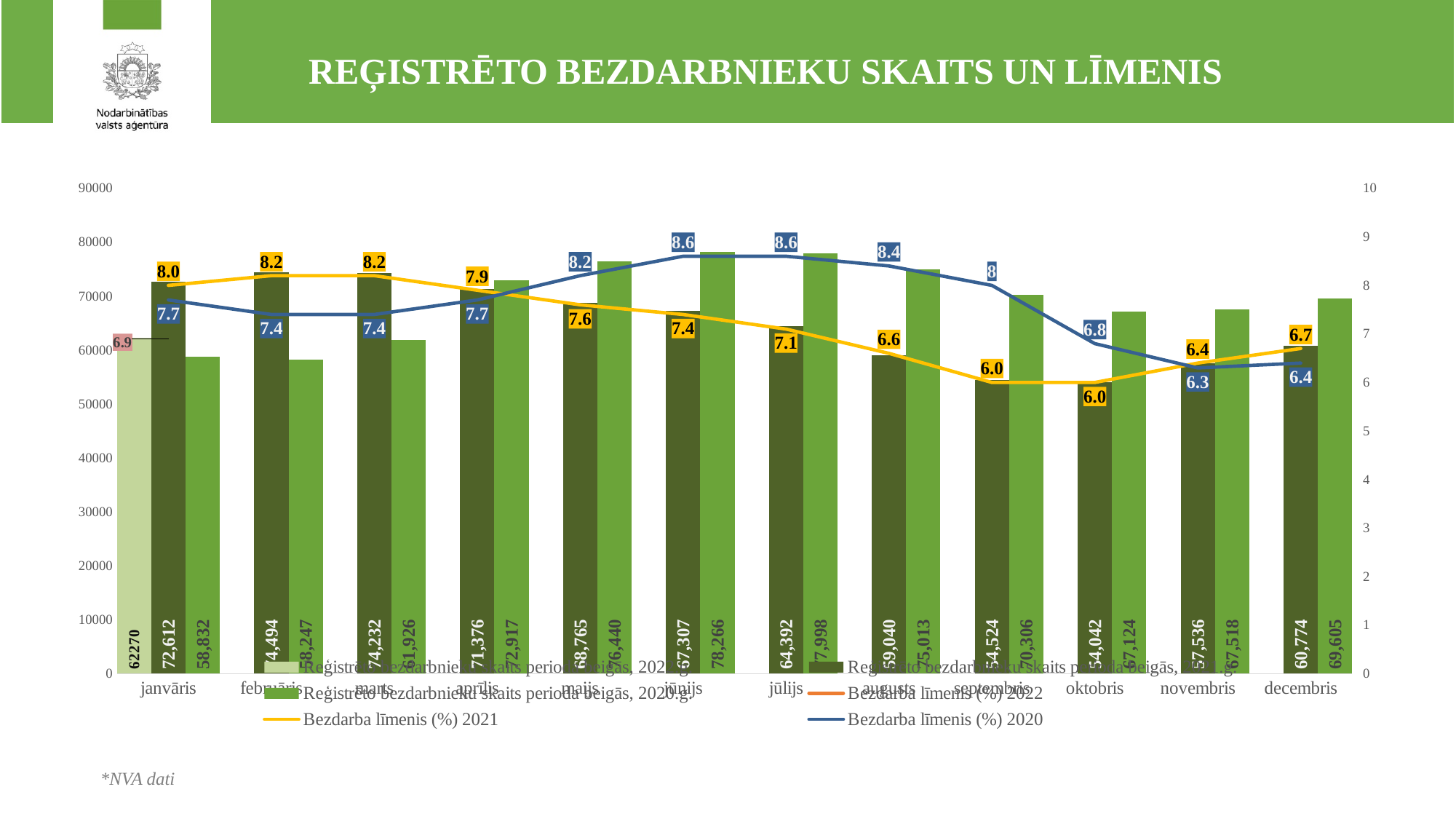
What is the unemployment rate (Bezdarba līmenis) for 2020 in jūnijs? 8.6 What kind of chart is shown on the slide? Combined bar and line chart In which month is the 2020 registered unemployed count (light green bars) highest? jūnijs What is the difference between the 2020 and 2021 registered unemployed counts in decembris? 8,831 How many months are shown on the x axis? 12 In which month is the 2021 registered unemployed count (dark green bars) lowest? oktobris What is the registered unemployed count shown for janvāris 2022 (pale green bar)? 62270 In janvāris, which is larger: the 2021 registered unemployed count or the 2020 count? 2021 (72,612) In which month is the 2021 registered unemployed count (dark green bars) highest? februāris Does the 2021 unemployment rate line rise or fall from marts to oktobris? Falls What is the registered unemployed count at the end of jūnijs in 2021 (dark green bar)? 67,307 What is the 2021 unemployment rate in septembris? 6.0